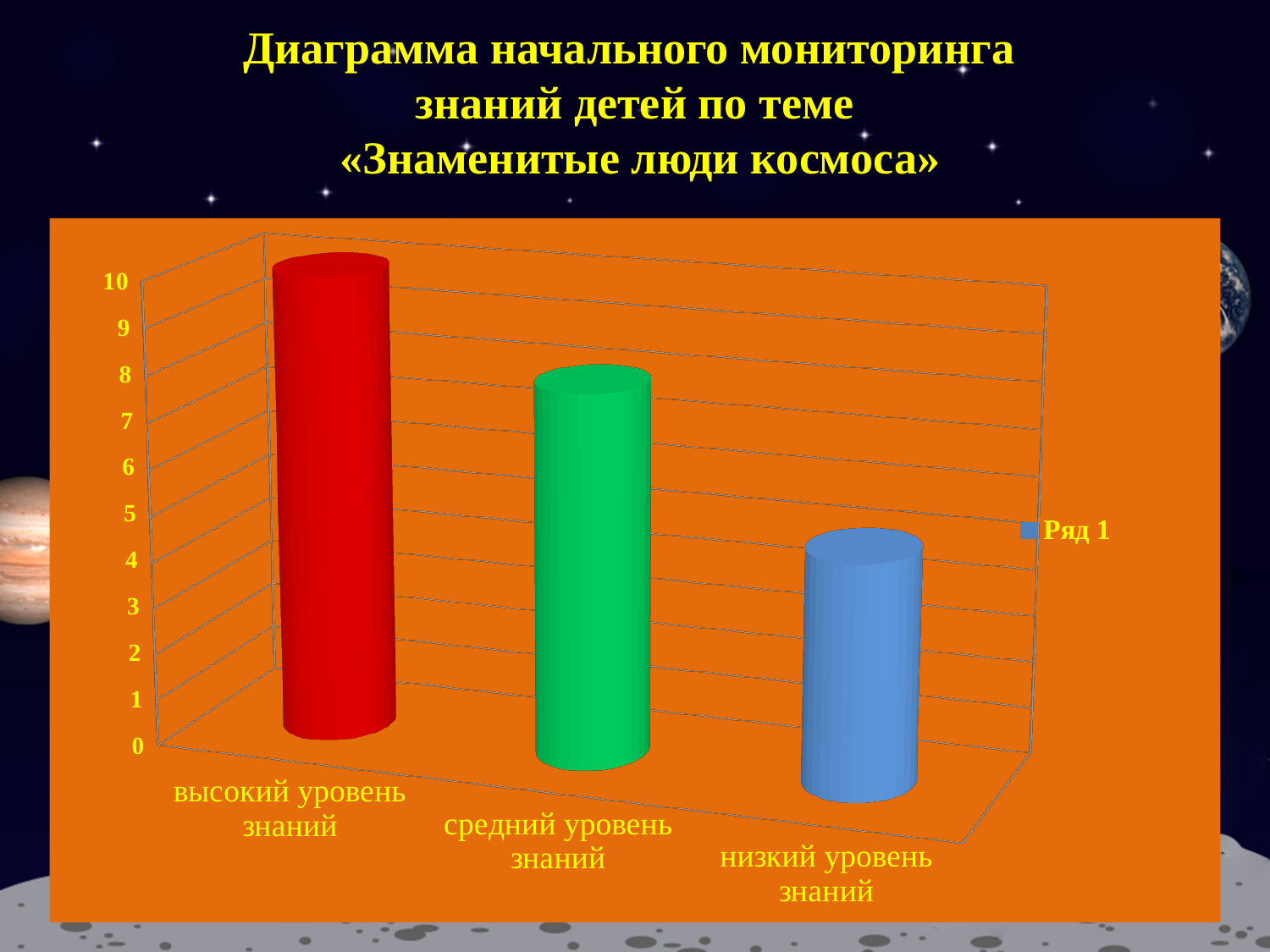
Which is larger, the value for средний уровень знаний or the value for низкий уровень знаний? средний уровень знаний Which category has the highest value? высокий уровень знаний Which is larger, the value for высокий уровень знаний or the value for низкий уровень знаний? высокий уровень знаний How many categories are plotted on the chart? 3 Is the value for высокий уровень знаний greater or less than 5? greater What kind of chart is shown on the slide? bar chart Is the value for средний уровень знаний greater or less than 5? greater Which category has the lowest value? низкий уровень знаний Is the value for низкий уровень знаний greater or less than 8? less Do the values rise or fall from left to right across the categories? fall How many series does the legend list? 1 What is the name of the series shown in the legend? Ряд 1